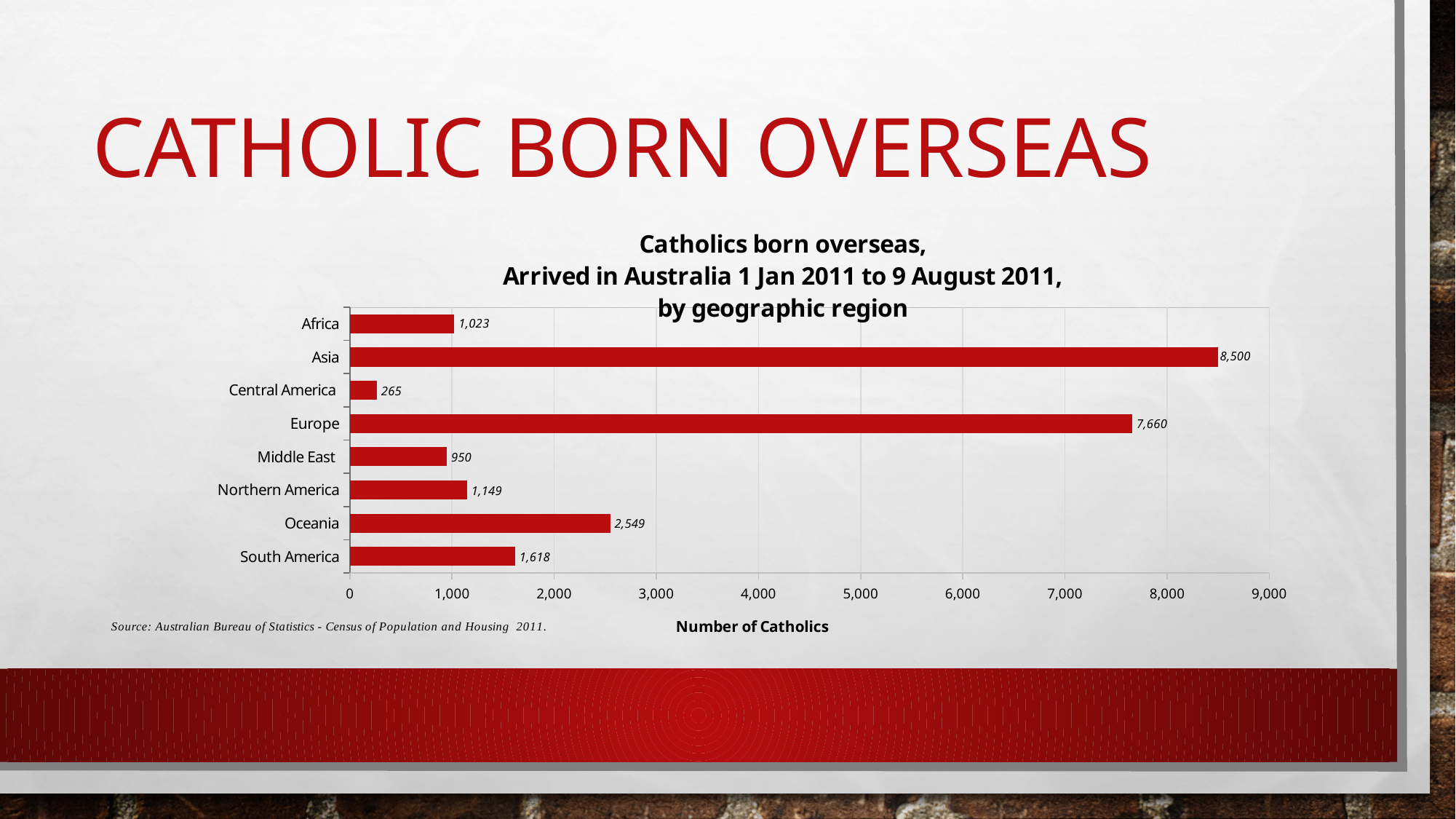
Which geographic region has the highest number of Catholics in the chart? Asia Which geographic region has the lowest number of Catholics in the chart? Central America Is the value for Middle East greater or less than 1,000? less What is the difference between the values for Oceania and South America? 931 What is the difference between the values for Asia and Europe? 840 What value is shown for Central America in the chart? 265 What kind of chart is shown on the slide? Bar chart Which has a larger value, Northern America or South America? South America What is the number of Catholics born in Asia who arrived in Australia, according to the chart? 8,500 What is the label of the horizontal axis of the chart? Number of Catholics What value is shown for Oceania in the chart? 2,549 How many geographic regions are shown in the chart? 8